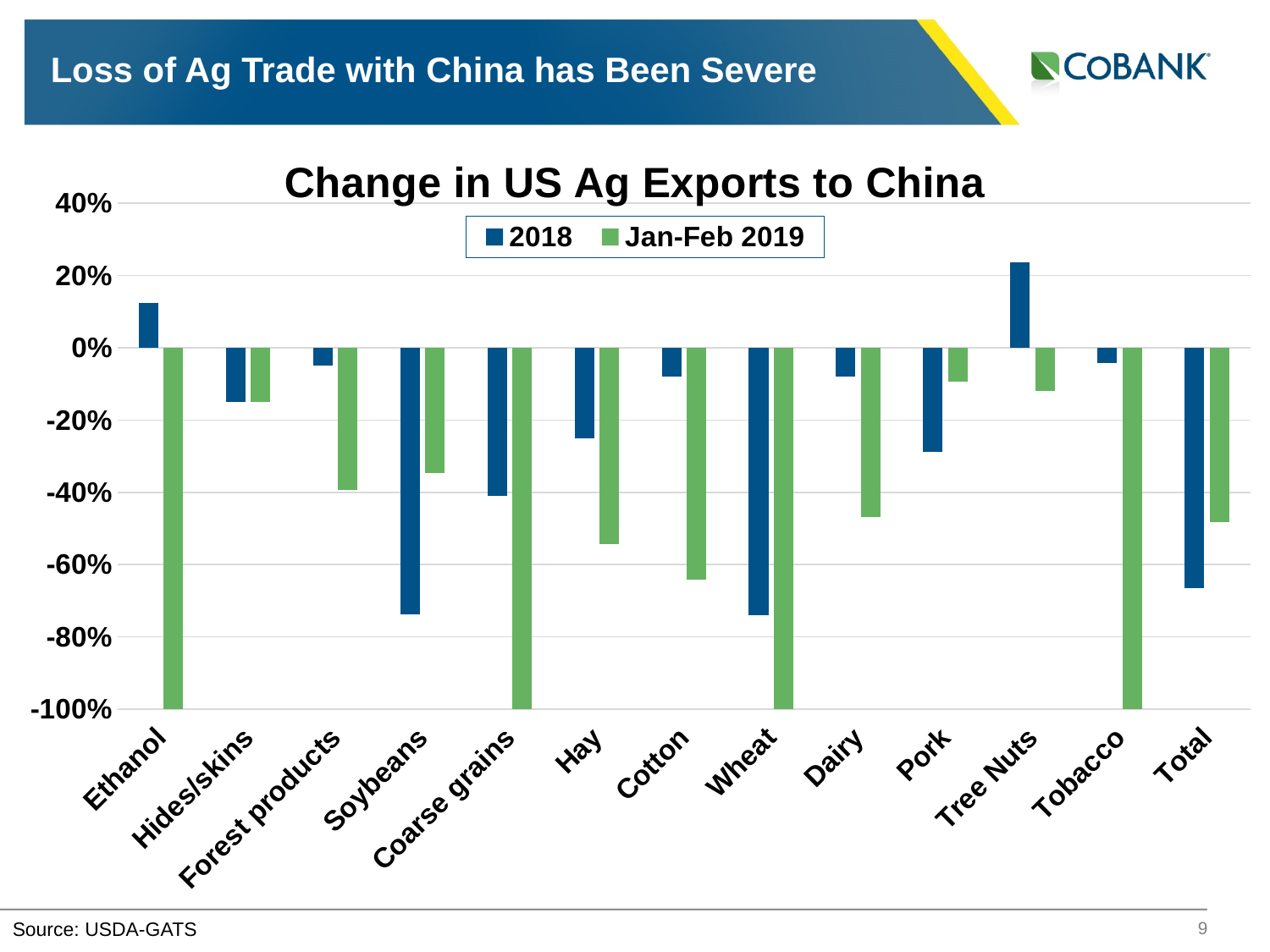
Is the 2018 value for Soybeans greater or less than -60%? less What is the Jan-Feb 2019 value for Ethanol? -100% What is the Jan-Feb 2019 value for Wheat? -100% What is the Jan-Feb 2019 value for Tobacco? -100% Is the Jan-Feb 2019 value for Dairy greater or less than -40%? less How many series does the legend list? 2 What type of chart is shown on the slide? Bar chart Which category has the highest 2018 value? Tree Nuts How many categories are shown on the x axis? 13 What is the title of the chart? Change in US Ag Exports to China For Soybeans, which is larger: the 2018 value or the Jan-Feb 2019 value? Jan-Feb 2019 Which colour represents the Jan-Feb 2019 series in the legend? Green